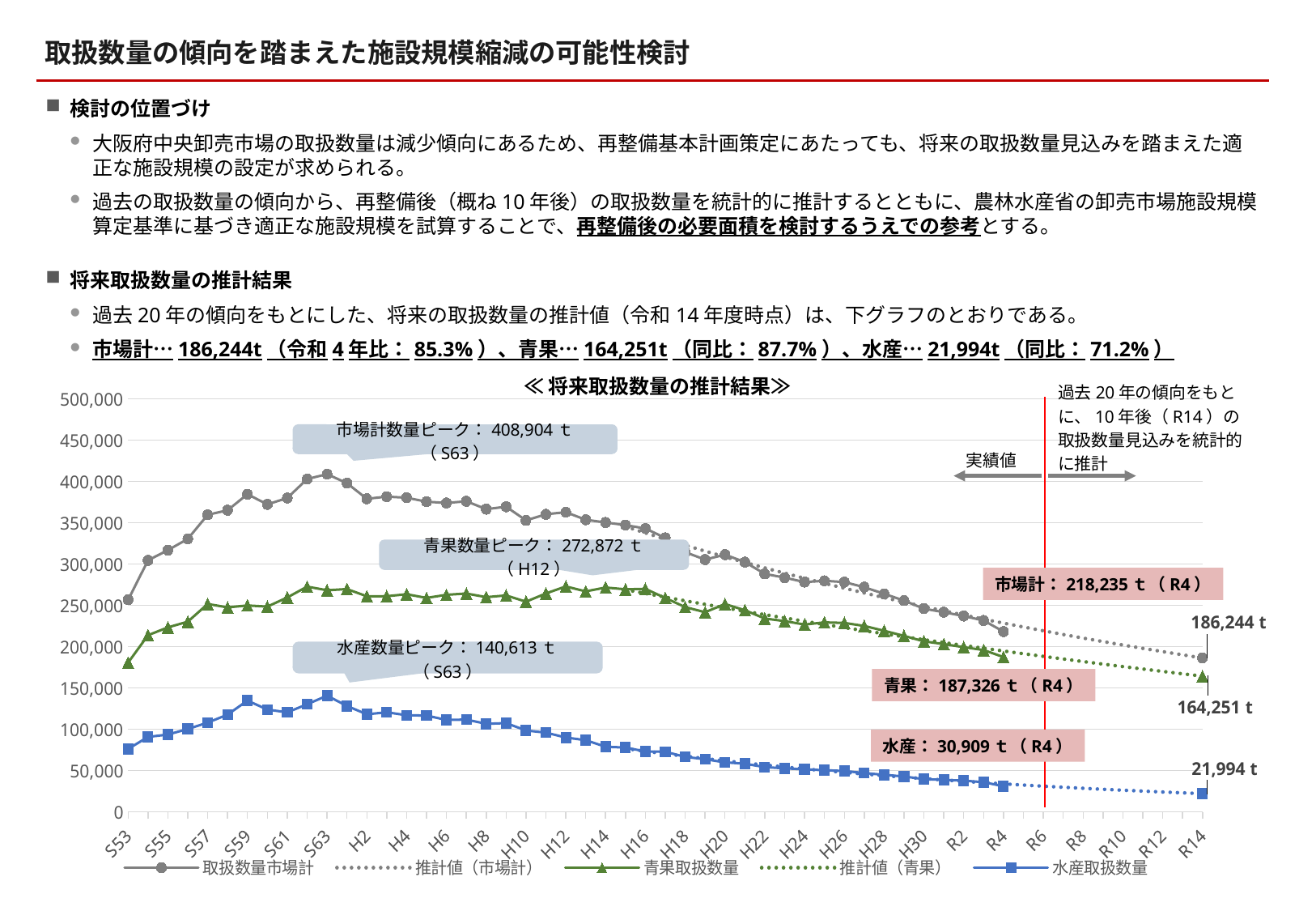
What is the projected value for 青果 in R14? 164,251 t What is the difference between the 青果 value in R4 and its projected value in R14? 23,075 t What kind of chart is shown on the slide? line chart Which is larger in R4, the 青果 value or the 水産 value? 青果 Does the 市場計 line rise or fall from S63 to R4? falls How many series does the legend list? 5 In which year did 青果 (fruit and vegetables) reach its peak of 272,872 t? H12 Is the 市場計 value in S53 greater or less than 300,000? less By how much is the projected 市場計 value in R14 lower than the R4 value? 31,991 t What is the difference between the 水産 value in R4 and its projected value in R14? 8,915 t What is the peak value of 市場計 (total market volume) shown on the chart? 408,904 t What is the value for 水産 (fisheries) in R4? 30,909 t